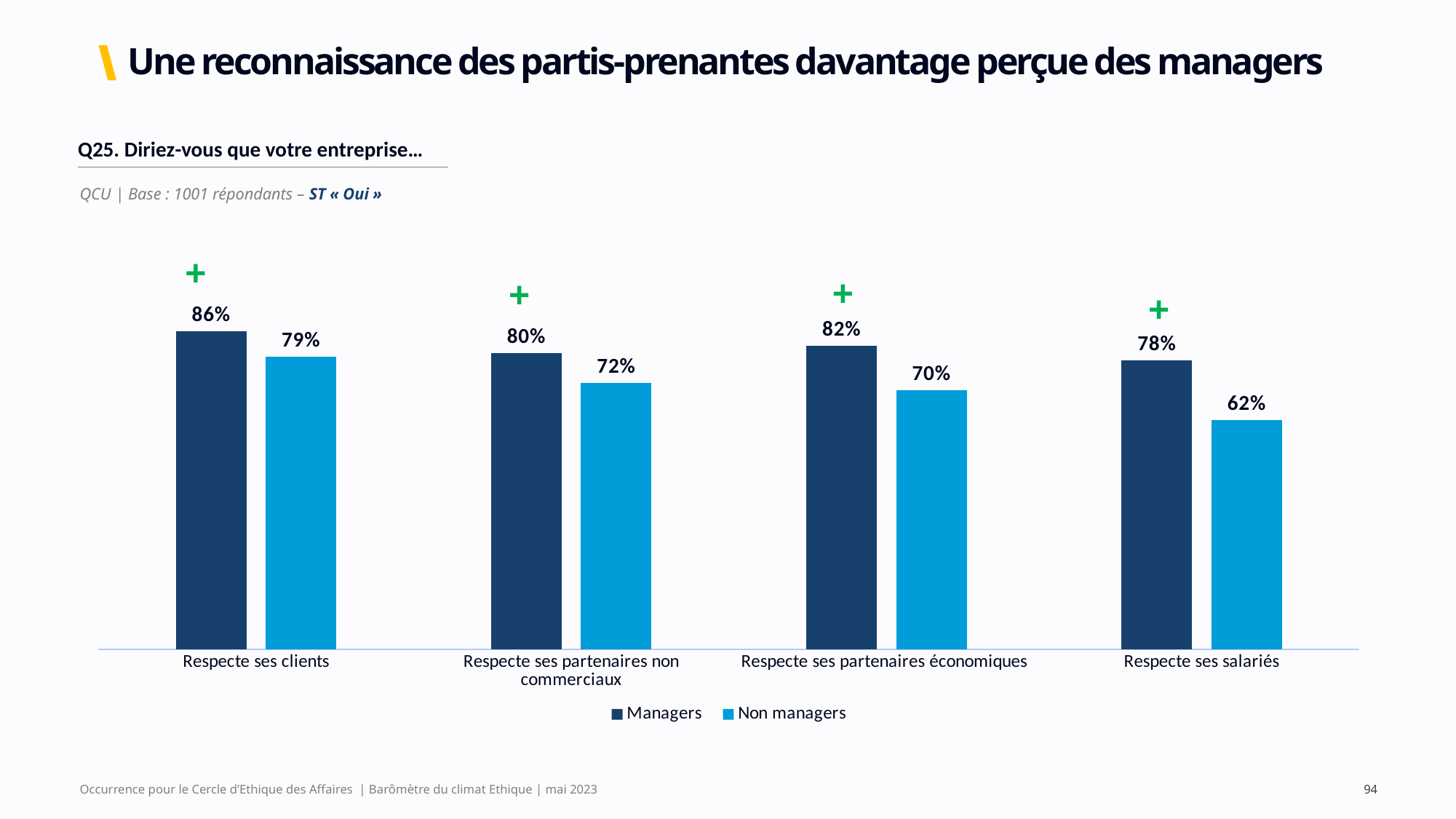
What kind of chart is shown on the slide? Bar chart What is the value for Non managers for "Respecte ses partenaires non commerciaux"? 72% What is the value for Non managers for "Respecte ses salariés"? 62% What is the value for Managers for "Respecte ses clients"? 86% How many series does the legend list? 2 Which is larger for "Respecte ses partenaires économiques": Managers or Non managers? Managers What is the value for Managers for "Respecte ses partenaires économiques"? 82% What is the difference between Managers and Non managers for "Respecte ses clients"? 7 percentage points How many categories are shown on the x axis? 4 What is the difference between Managers and Non managers for "Respecte ses salariés"? 16 percentage points Which category has the highest value for Managers? Respecte ses clients Which category has the lowest value for Non managers? Respecte ses salariés